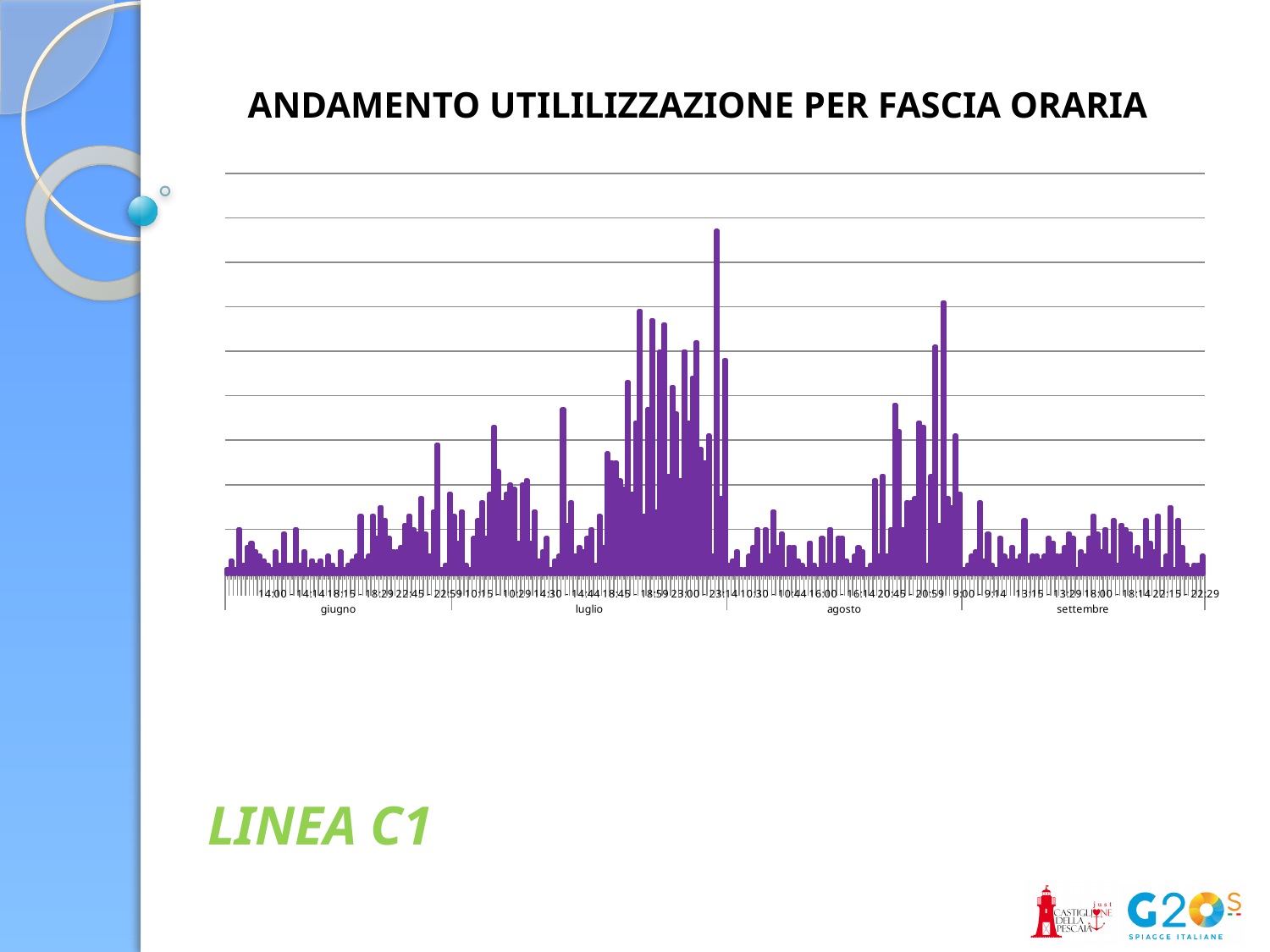
Which month group on the x axis contains the tallest bar in the chart? luglio What kind of chart is shown on the slide? bar chart Which month group has the higher peak bar, luglio or agosto? luglio How many month groups are labelled along the x axis of the chart? 4 Which month group has the higher peak bar, luglio or giugno? luglio What colour are the bars in the chart? purple Which month group has the higher peak bar, agosto or settembre? agosto Which month is labelled last (rightmost) on the x axis? settembre What is the title of the chart? ANDAMENTO UTILILIZZAZIONE PER FASCIA ORARIA